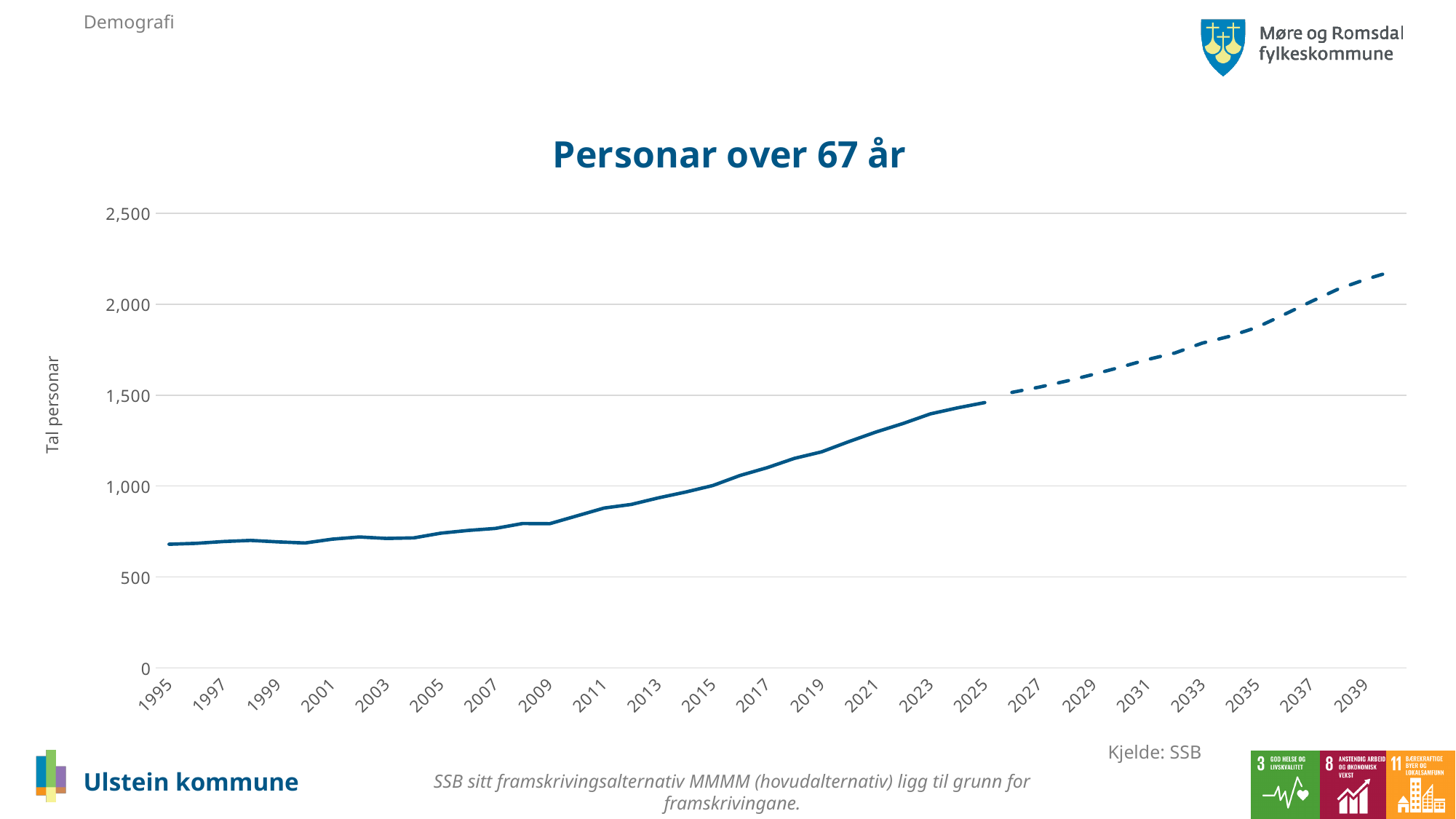
Is the value for 2031 greater or less than 1,500? greater Which year has the larger value, 1995 or 2023? 2023 Which year has the larger value, 2011 or 2035? 2035 Is the value for 2009 greater or less than 1,000? less Is the value for 2039 greater or less than 2,000? greater What is the title of the chart? Personar over 67 år What is the label on the vertical axis of the chart? Tal personar Do the values in the chart generally rise or fall from 1995 to 2039? rise What kind of chart is shown on the slide? line chart